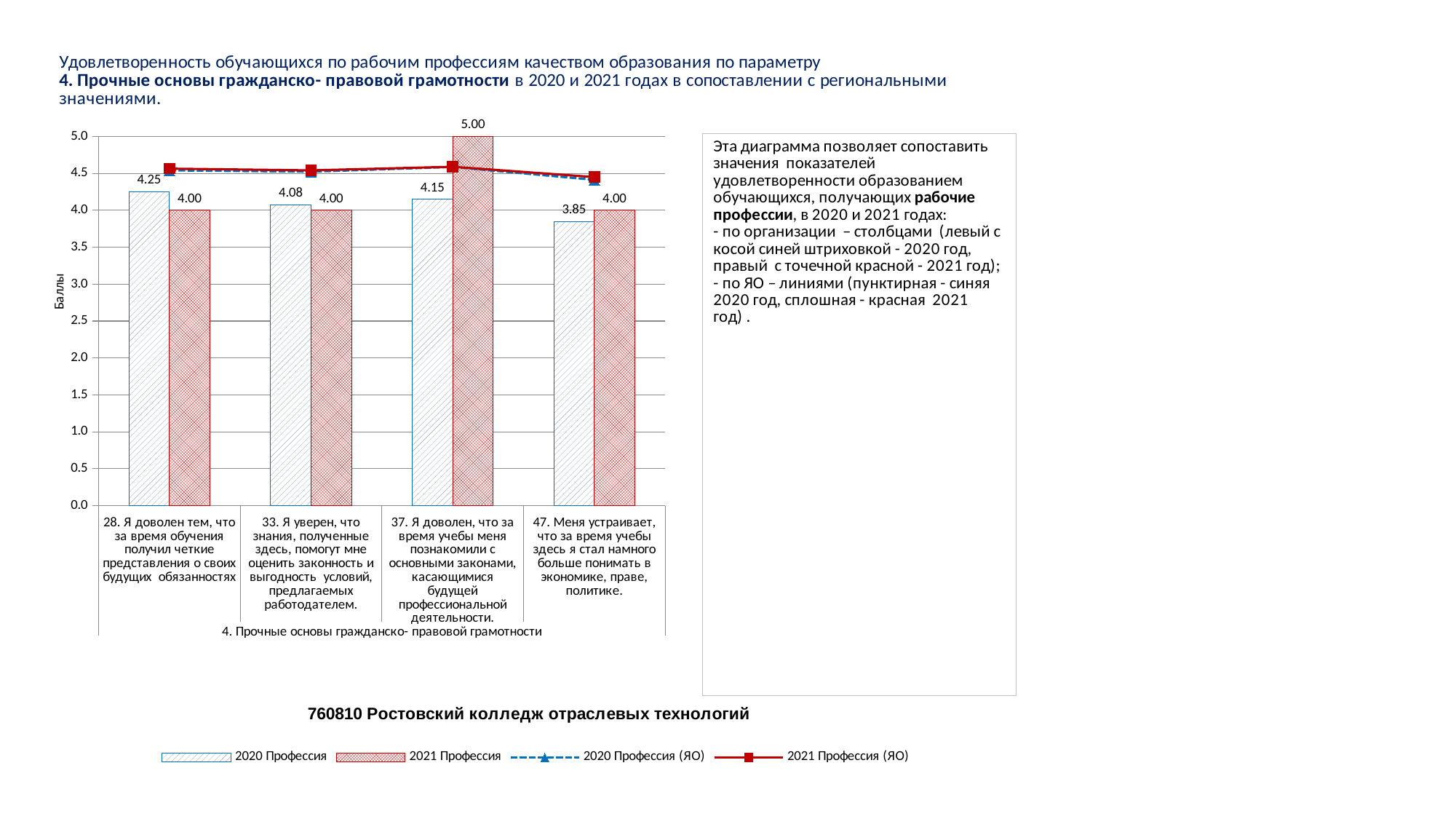
Is the 2021 Профессия (ЯО) line value for question 37 greater or less than 4.5? greater How many series does the legend list? 4 What is the label of the vertical axis? Баллы For question 28, which is larger: the 2020 Профессия value or the 2021 Профессия value? 2020 Профессия What is the 2020 Профессия value for question 28 ("Я доволен тем, что за время обучения получил четкие представления о своих будущих обязанностях")? 4.25 What is the 2020 Профессия value for question 47 ("Меня устраивает, что за время учебы здесь я стал намного больше понимать в экономике, праве, политике")? 3.85 What is the 2020 Профессия value for question 33 ("Я уверен, что знания, полученные здесь, помогут мне оценить законность и выгодность условий, предлагаемых работодателем")? 4.08 How many question categories are shown on the x axis? 4 Which question has the highest 2020 Профессия value? 28. Я доволен тем, что за время обучения получил четкие представления о своих будущих обязанностях What is the difference between the 2021 Профессия and 2020 Профессия values for question 37? 0.85 Which question has the lowest 2020 Профессия value? 47. Меня устраивает, что за время учебы здесь я стал намного больше понимать в экономике, праве, политике. What is the 2021 Профессия value for question 37 ("Я доволен, что за время учебы меня познакомили с основными законами...")? 5.00